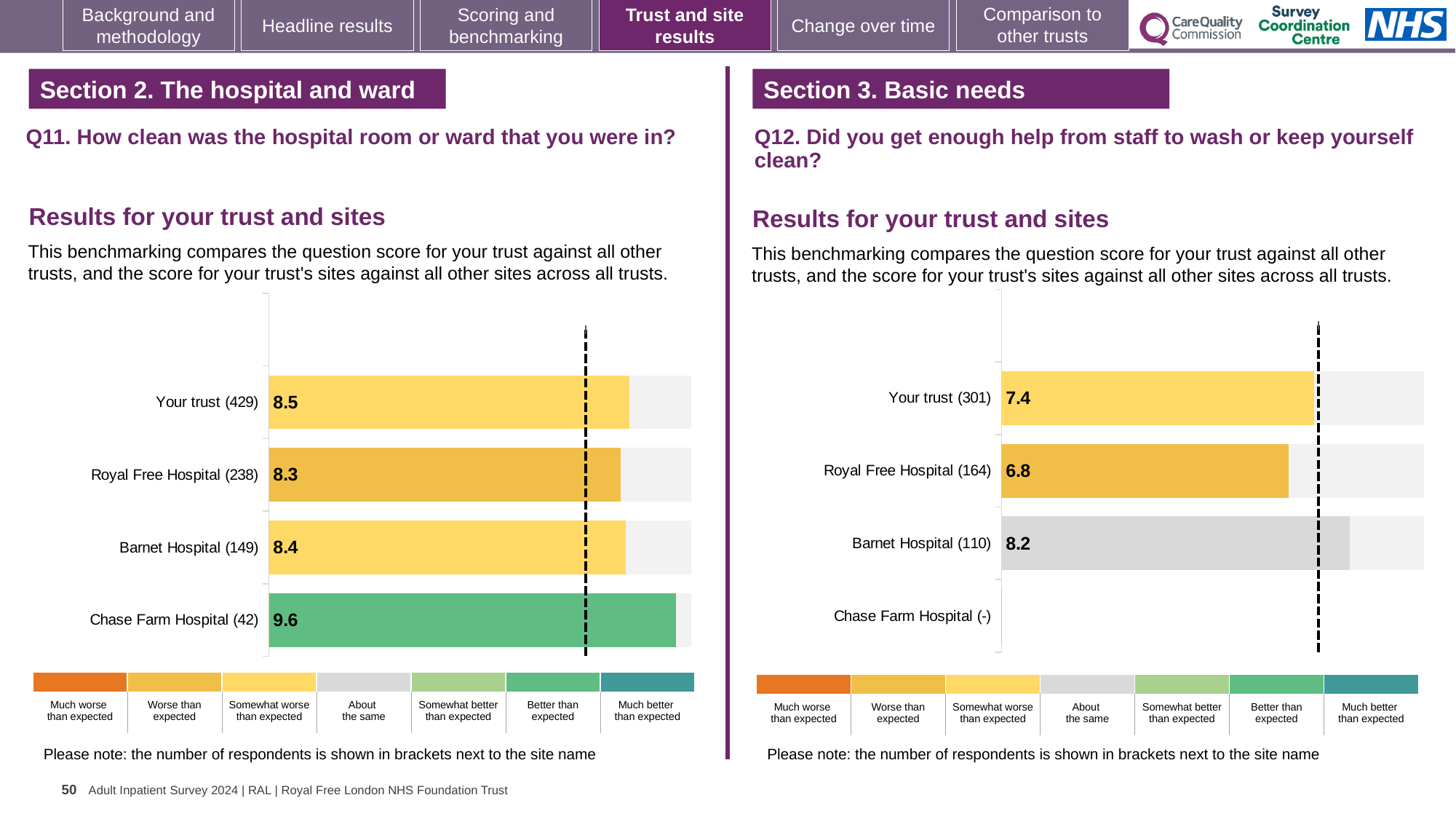
In the Q11 chart on the left, what is the difference between the scores for Chase Farm Hospital and Royal Free Hospital? 1.3 In the Q11 chart on the left, what is the score for Your trust? 8.5 What kind of chart is used for the Q11 results on the left? Bar chart In the Q11 chart on the left, how many bars are plotted? 4 In the Q11 chart on the left, what is the score for Chase Farm Hospital? 9.6 In the Q11 chart on the left, which bar has the lowest score? Royal Free Hospital In the Q12 chart on the right, what is the score for Barnet Hospital? 8.2 In the Q12 chart on the right, what is the difference between the scores for Barnet Hospital and Your trust? 0.8 In the Q12 chart on the right, how many sites have a score shown as a bar? 3 In the Q12 chart on the right, what is the score for Royal Free Hospital? 6.8 In the Q12 chart on the right, which is larger: the score for Your trust or the score for Royal Free Hospital? Your trust In the Q11 chart on the left, which site has the highest score? Chase Farm Hospital